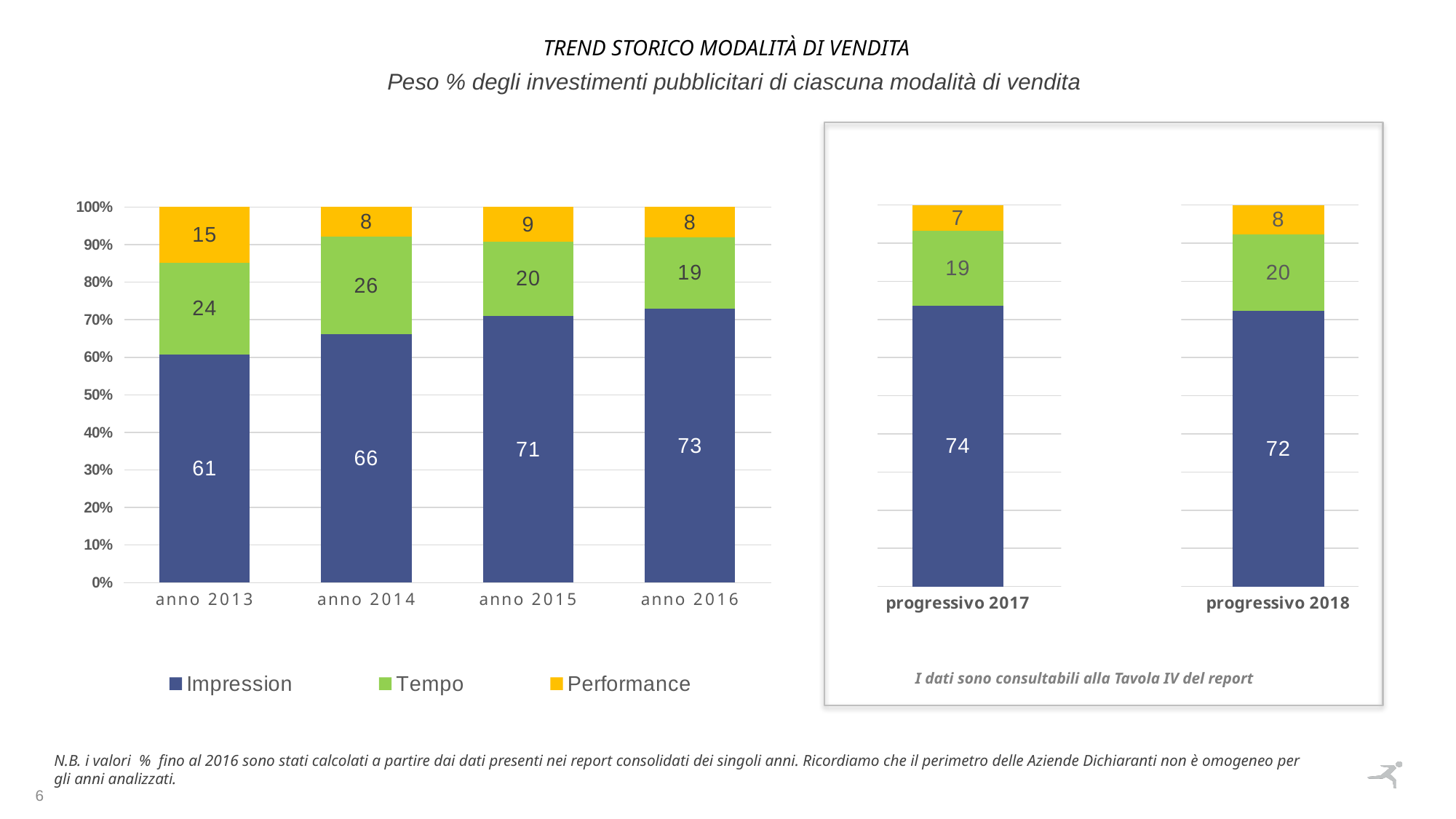
In the left chart, does the Impression value rise or fall from anno 2013 to anno 2016? rise In the left chart, is the Tempo value larger for anno 2014 or anno 2015? anno 2014 How many series does the legend list? 3 In the left chart, which year has the highest Impression value? anno 2016 In the right chart, what is the Tempo value for progressivo 2018? 20 In the left chart, what is the Performance value for anno 2015? 9 In the left chart, what is the Impression value for anno 2013? 61 What kind of chart is the left chart? stacked bar chart In the right chart, what is the Impression value for progressivo 2017? 74 In the left chart, what is the difference between the Impression values for anno 2016 and anno 2013? 12 How many categories are shown on the x axis of the left chart? 4